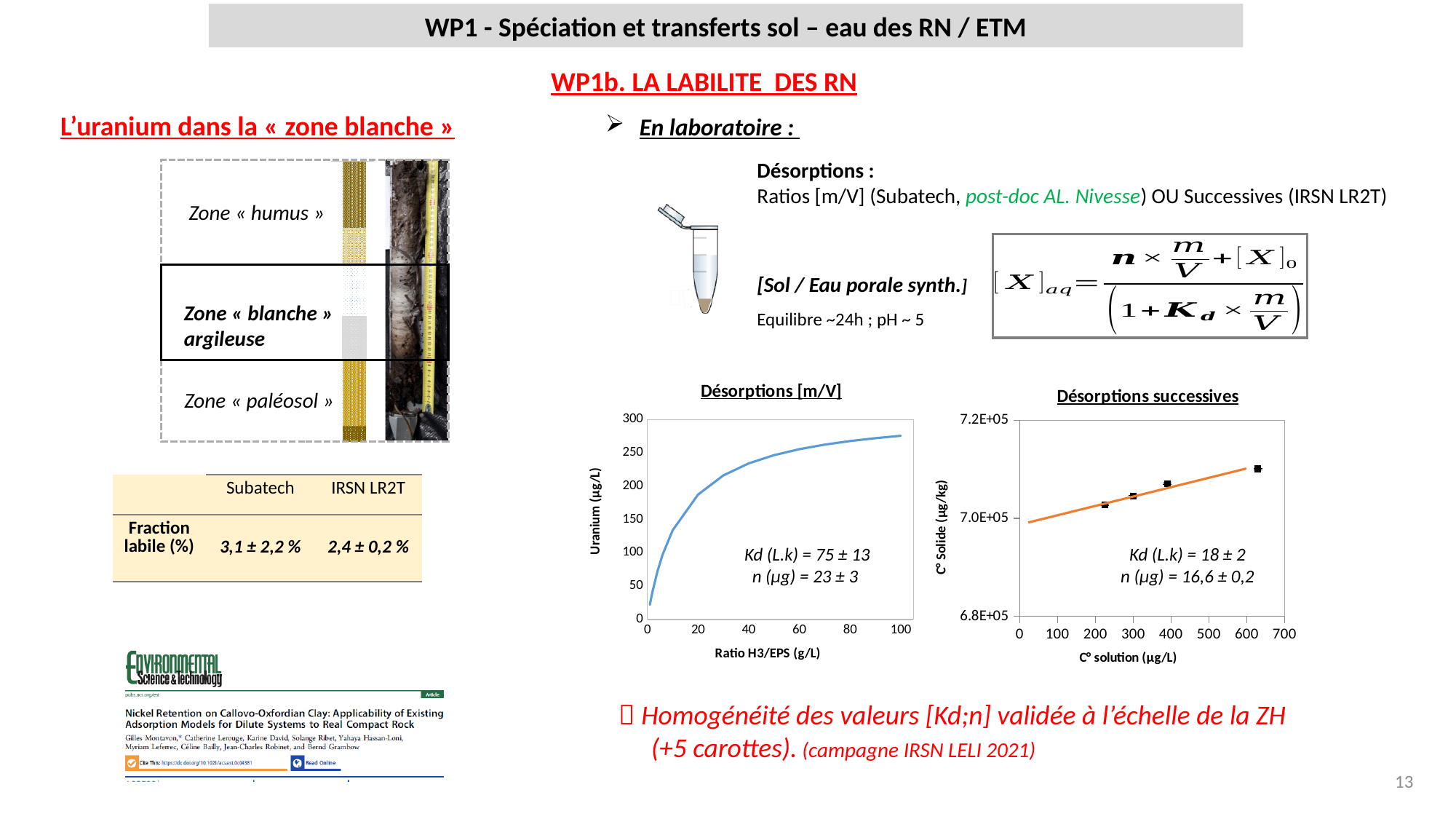
In the "Désorptions [m/V]" chart, is the uranium value at a ratio of 20 g/L greater or less than 150? greater In the "Désorptions [m/V]" chart, is the uranium value at a ratio of 40 g/L greater or less than 200? greater In the "Désorptions successives" chart, is the C° Solide value of the point at about 630 µg/L greater or less than 7.0E+05? greater In the "Désorptions successives" chart, does C° Solide rise or fall as C° solution increases? rise What kind of chart is the "Désorptions [m/V]" chart? line chart How many data points are plotted in the "Désorptions successives" chart? 4 What Kd value is annotated on the "Désorptions successives" chart? Kd (L.k) = 18 ± 2 In the "Désorptions [m/V]" chart, does the uranium concentration rise or fall as the Ratio H3/EPS increases? rise What is the x-axis title of the "Désorptions [m/V]" chart? Ratio H3/EPS (g/L) What kind of chart is the "Désorptions successives" chart? scatter chart